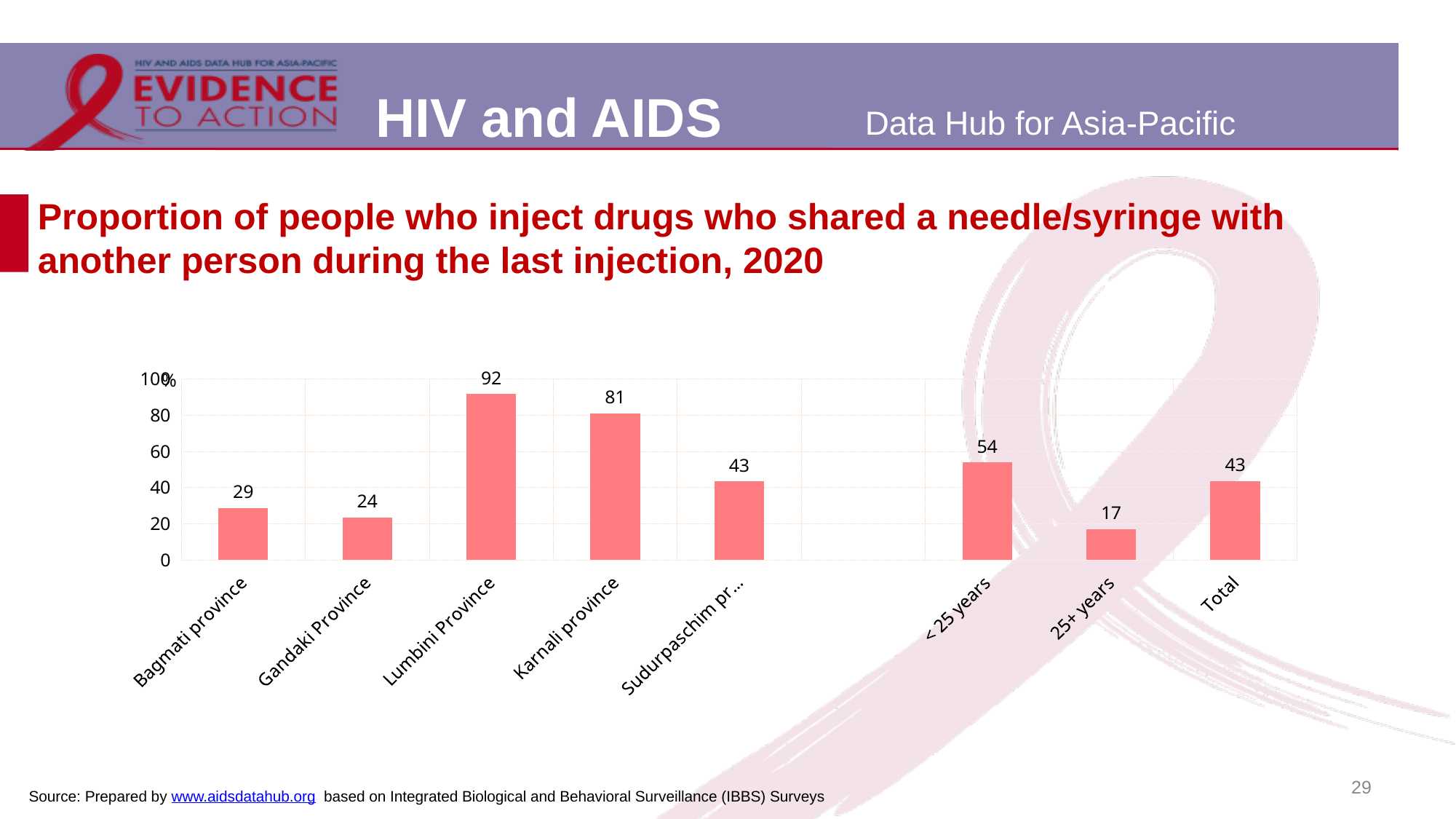
What is the difference between the values for < 25 years and 25+ years? 37 What is the value for Lumbini Province? 92 Which category has the highest value? Lumbini Province Which is larger, the value for Bagmati province or Gandaki Province? Bagmati province What is the value for Bagmati province? 29 What is the value for Total? 43 How many bars are shown in the chart? 8 What is the difference between the values for Lumbini Province and Karnali province? 11 What kind of chart is shown on the slide? Bar chart Which category has the lowest value? 25+ years What is the maximum value shown on the vertical axis? 100 What is the value for the 25+ years group? 17